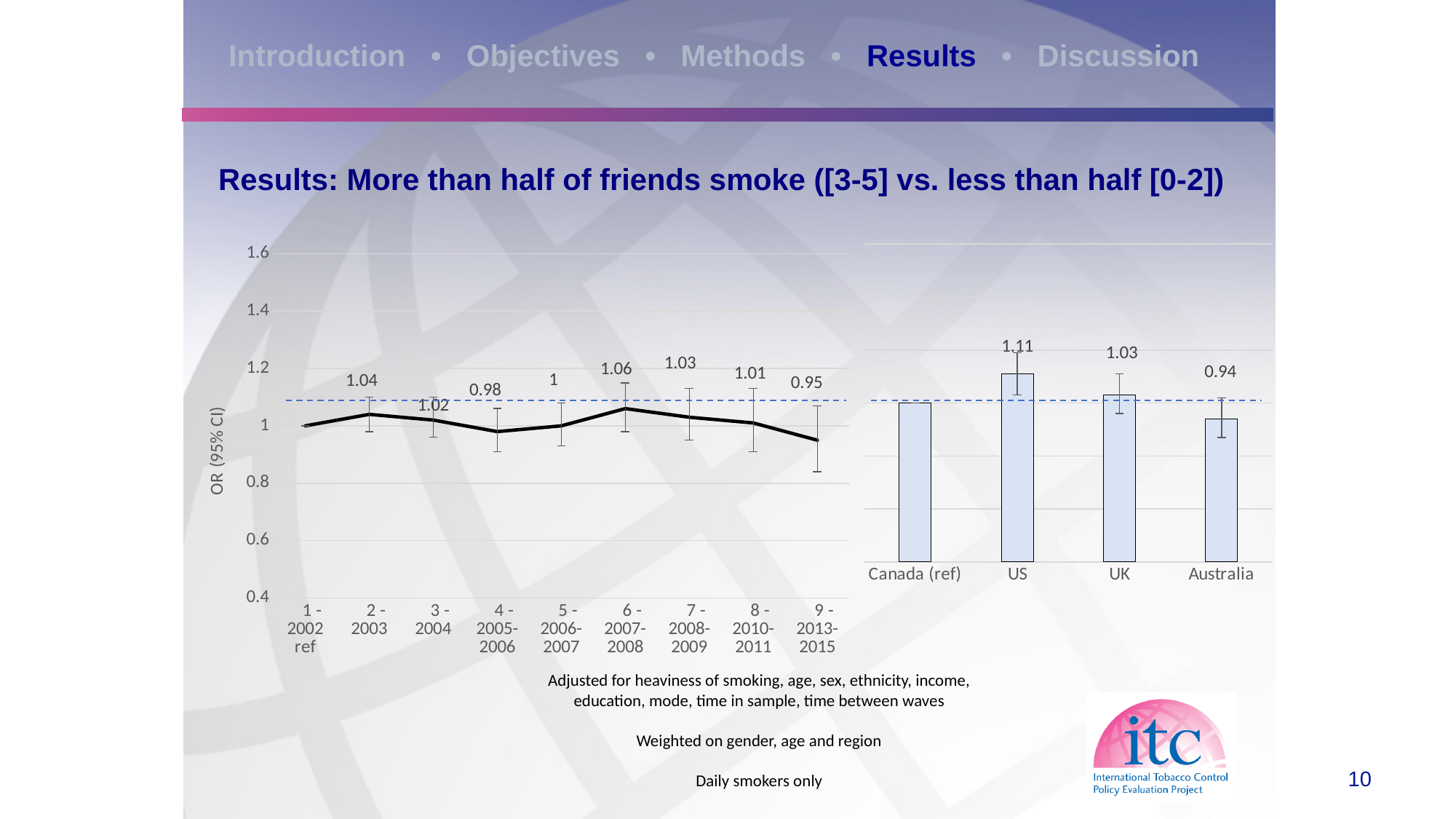
On the left line chart, what is the difference between the values for wave 6 (2007-2008) and wave 9 (2013-2015)? 0.11 On the right bar chart, what is the value for Australia? 0.94 On the left line chart, what is the value for wave 9 (2013-2015)? 0.95 On the right bar chart, what is the difference between the values for the US and the UK? 0.08 On the left line chart, which wave has the lowest labelled value? 9 - 2013-2015 On the left line chart, what is the value for wave 6 (2007-2008)? 1.06 On the left line chart, how many waves are plotted along the x axis? 9 On the right bar chart, what is the value for the US? 1.11 On the left line chart, which wave has the highest labelled value? 6 - 2007-2008 On the left line chart, what is the value for wave 4 (2005-2006)? 0.98 What type of chart is shown on the right side of the slide? Bar chart On the right bar chart, which country has the highest value? US